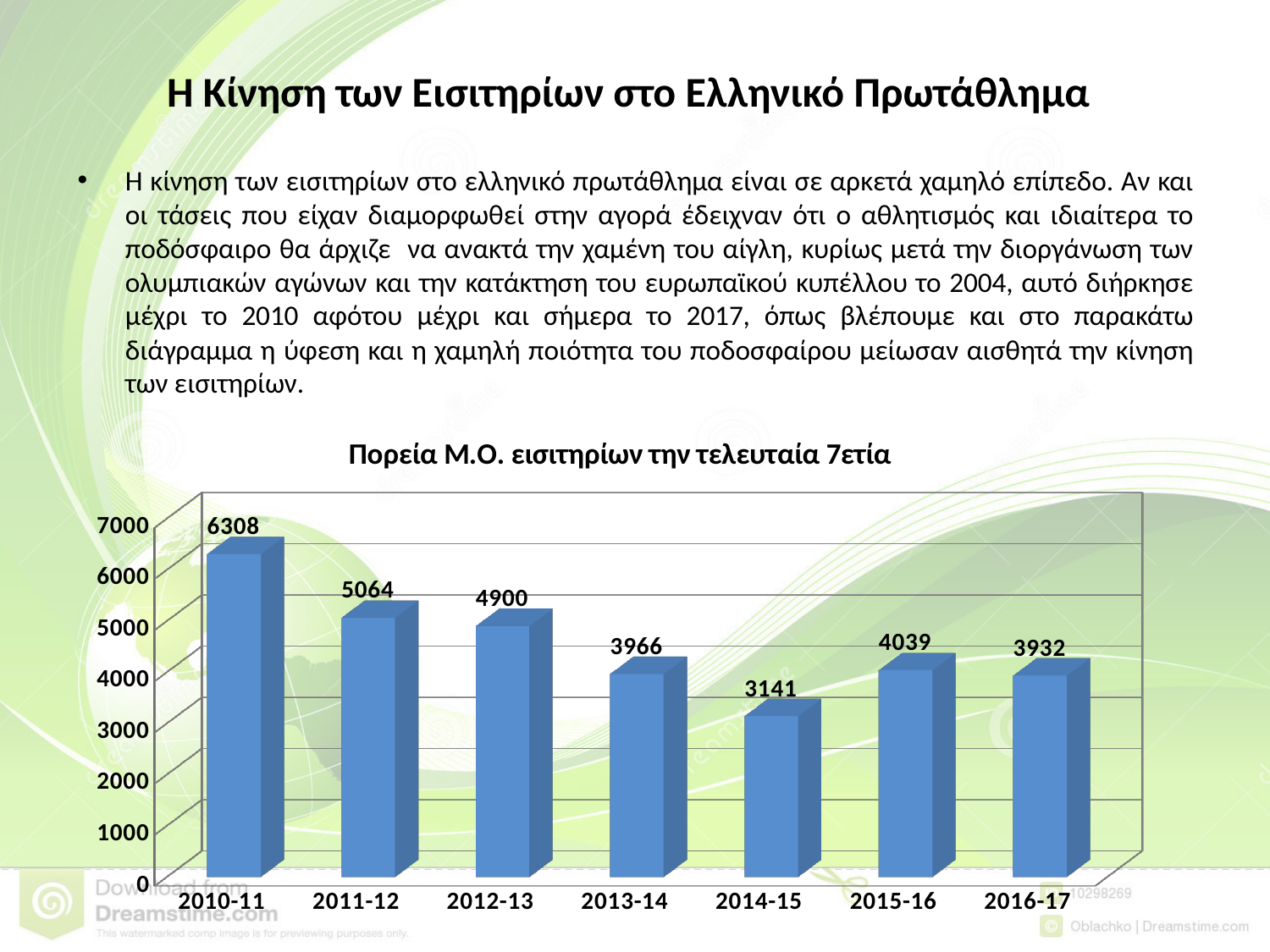
Which is larger, the value for 2012-13 or the value for 2013-14? 2012-13 What is the title of the chart? Πορεία Μ.Ο. εισιτηρίων την τελευταία 7ετία What is the difference between the values for 2015-16 and 2014-15? 898 Is the value for 2013-14 greater or less than 3000? greater What is the value for 2010-11? 6308 What is the difference between the values for 2010-11 and 2011-12? 1244 Which season has the lowest value? 2014-15 How many seasons are shown on the chart? 7 What kind of chart is shown on the slide? bar chart What is the value for 2014-15? 3141 Which season has the highest value? 2010-11 What is the value for 2016-17? 3932